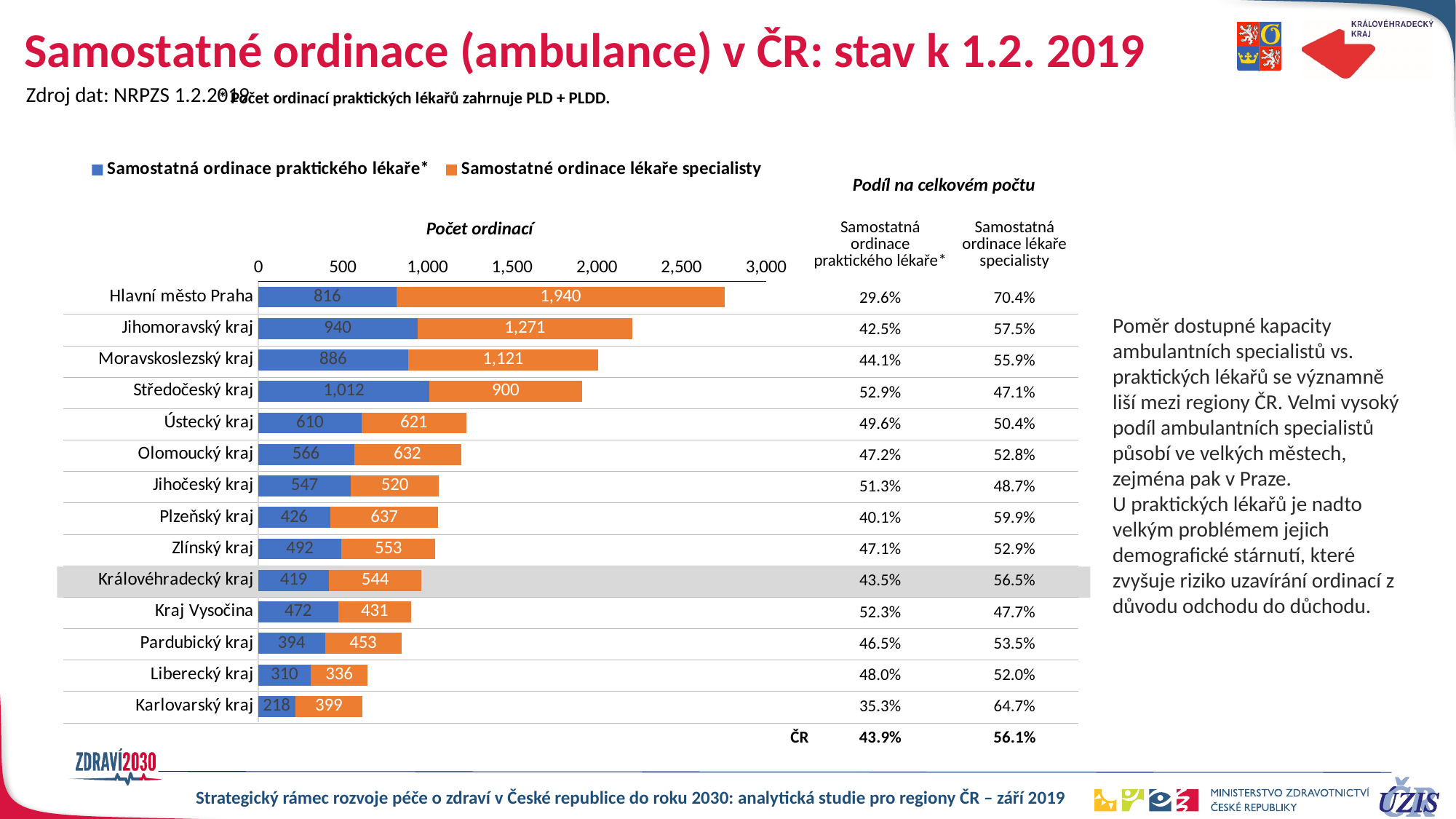
What is the difference between the 'Samostatné ordinace lékaře specialisty' value and the 'Samostatná ordinace praktického lékaře*' value for Hlavní město Praha? 1,124 What is the value of 'Samostatná ordinace praktického lékaře*' for Královéhradecký kraj? 419 What is the total of the stacked bar for Královéhradecký kraj? 963 How many regions (categories) are plotted in the chart? 14 Which is larger for Kraj Vysočina: 'Samostatná ordinace praktického lékaře*' or 'Samostatné ordinace lékaře specialisty'? Samostatná ordinace praktického lékaře* What type of chart is shown on the slide? stacked bar chart How many series does the chart legend list? 2 What is the value of 'Samostatné ordinace lékaře specialisty' for Hlavní město Praha? 1,940 Is the total of the stacked bar for Jihomoravský kraj greater or less than 2,000? greater Which region has the highest value for 'Samostatná ordinace praktického lékaře*'? Středočeský kraj Which region has the lowest value for 'Samostatné ordinace lékaře specialisty'? Liberecký kraj What is the title of the horizontal axis of the chart? Počet ordinací